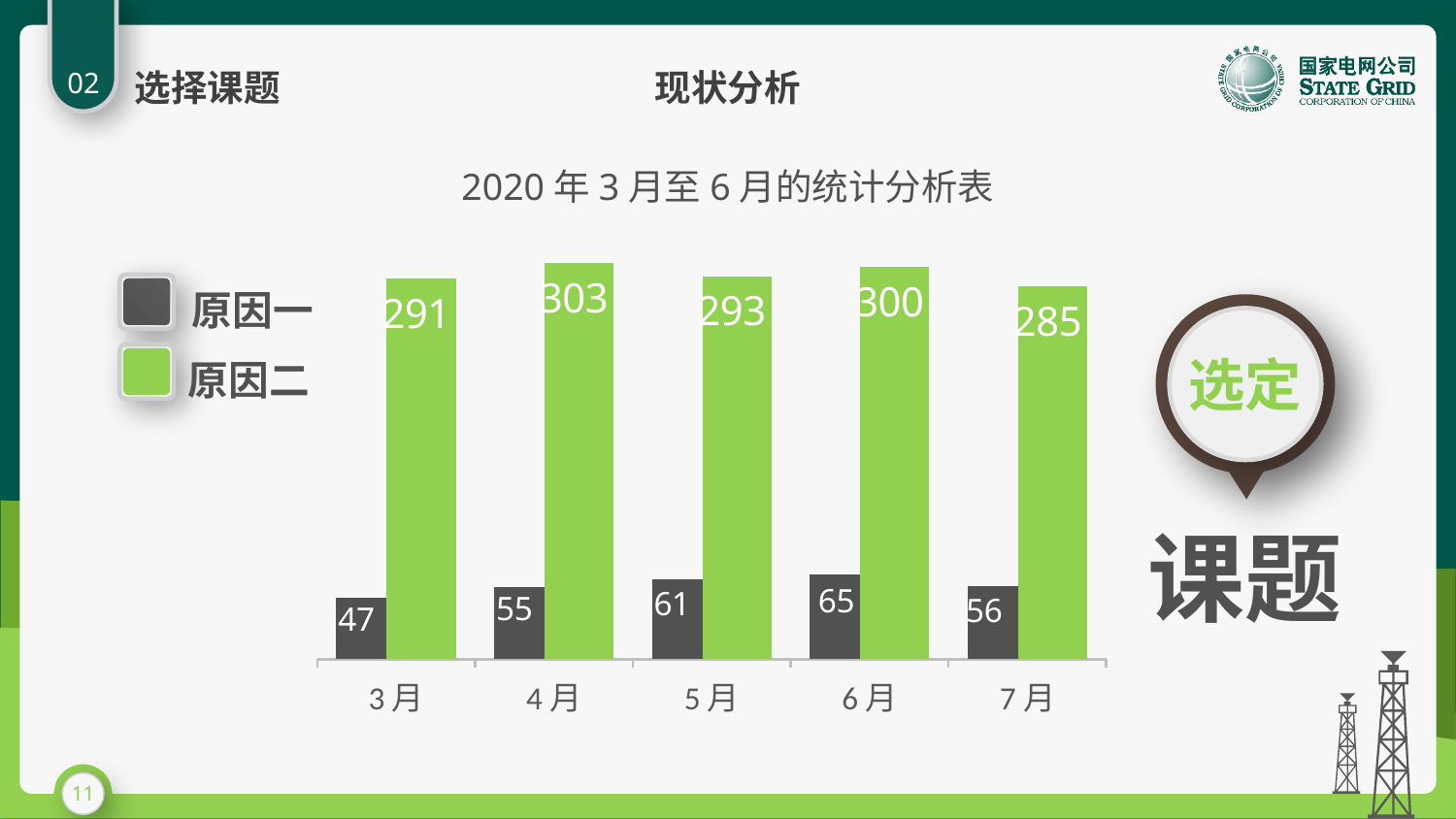
What is the difference between 原因二 and 原因一 in 5月? 232 How many months are shown on the x axis? 5 What kind of chart is shown on the slide? bar chart What is the value of 原因一 for 6月? 65 Which month has the lowest value for 原因二? 7月 Which month has the lowest value for 原因一? 3月 Which month has the highest value for 原因二? 4月 What is the total of 原因一 and 原因二 for 6月? 365 How many series does the legend list? 2 Which is larger: 原因一 in 4月 or 原因一 in 7月? 7月 What is the value of 原因一 for 3月? 47 What is the value of 原因二 for 4月? 303